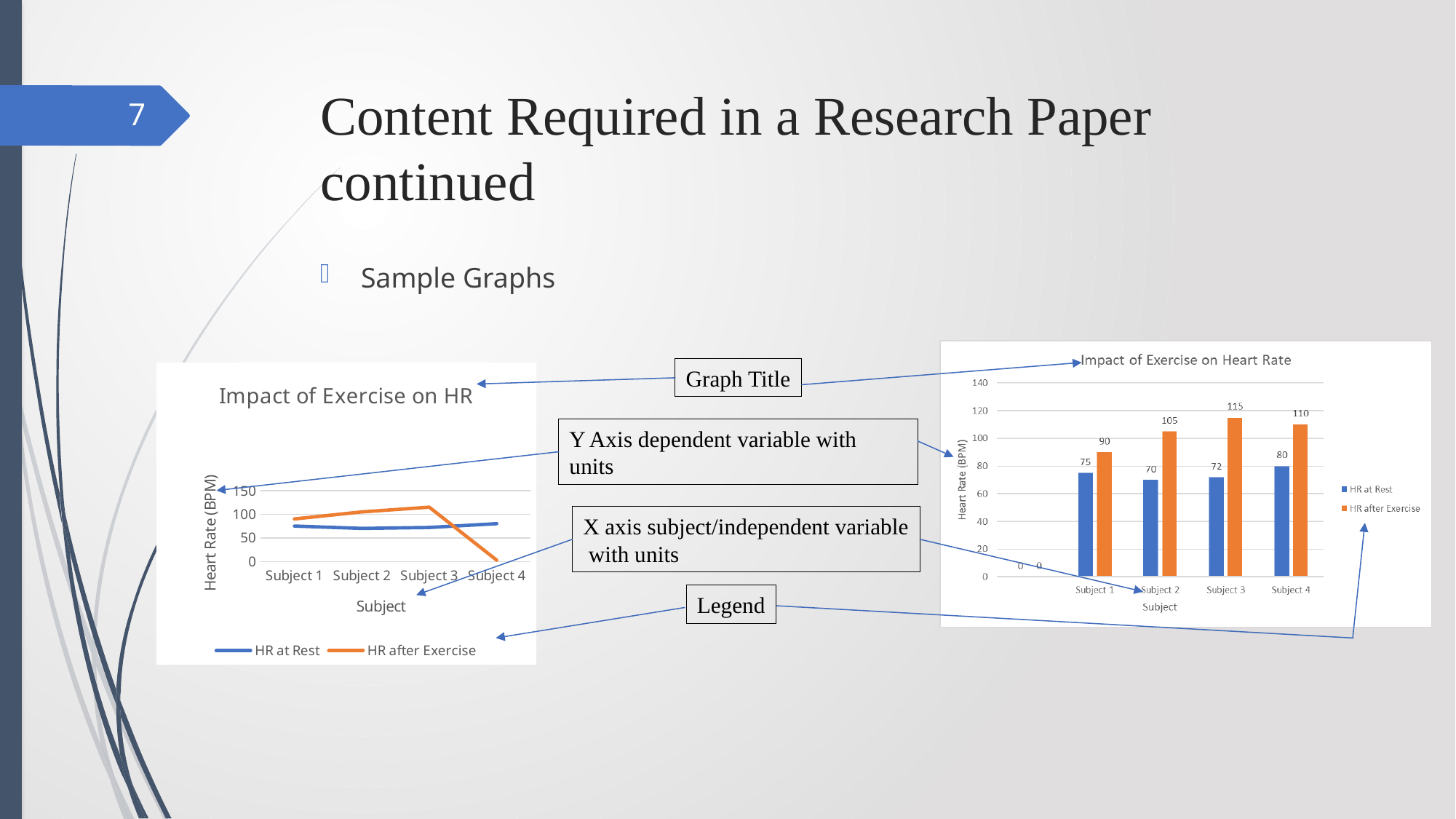
In the 'Impact of Exercise on Heart Rate' bar chart, what is the HR after Exercise value for Subject 3? 115 What kind of chart is the chart on the right of the slide, titled 'Impact of Exercise on Heart Rate'? Bar chart What kind of chart is the chart on the left of the slide, titled 'Impact of Exercise on HR'? Line chart In the 'Impact of Exercise on Heart Rate' bar chart, what is the difference between HR after Exercise and HR at Rest for Subject 1? 15 In the 'Impact of Exercise on HR' line chart, is the HR after Exercise value for Subject 4 greater or less than 50? less In the 'Impact of Exercise on Heart Rate' bar chart, which subject has the highest HR after Exercise? Subject 3 In the 'Impact of Exercise on Heart Rate' bar chart, how many subjects are shown on the x axis? 4 What is the y-axis label of the 'Impact of Exercise on HR' line chart? Heart Rate (BPM) In the 'Impact of Exercise on Heart Rate' bar chart, which subject has the lowest HR at Rest? Subject 2 In the 'Impact of Exercise on Heart Rate' bar chart, how many series does the legend list? 2 In the 'Impact of Exercise on Heart Rate' bar chart, what is the HR at Rest value for Subject 2? 70 In the 'Impact of Exercise on Heart Rate' bar chart, which is larger: HR after Exercise for Subject 2 or HR after Exercise for Subject 4? Subject 4